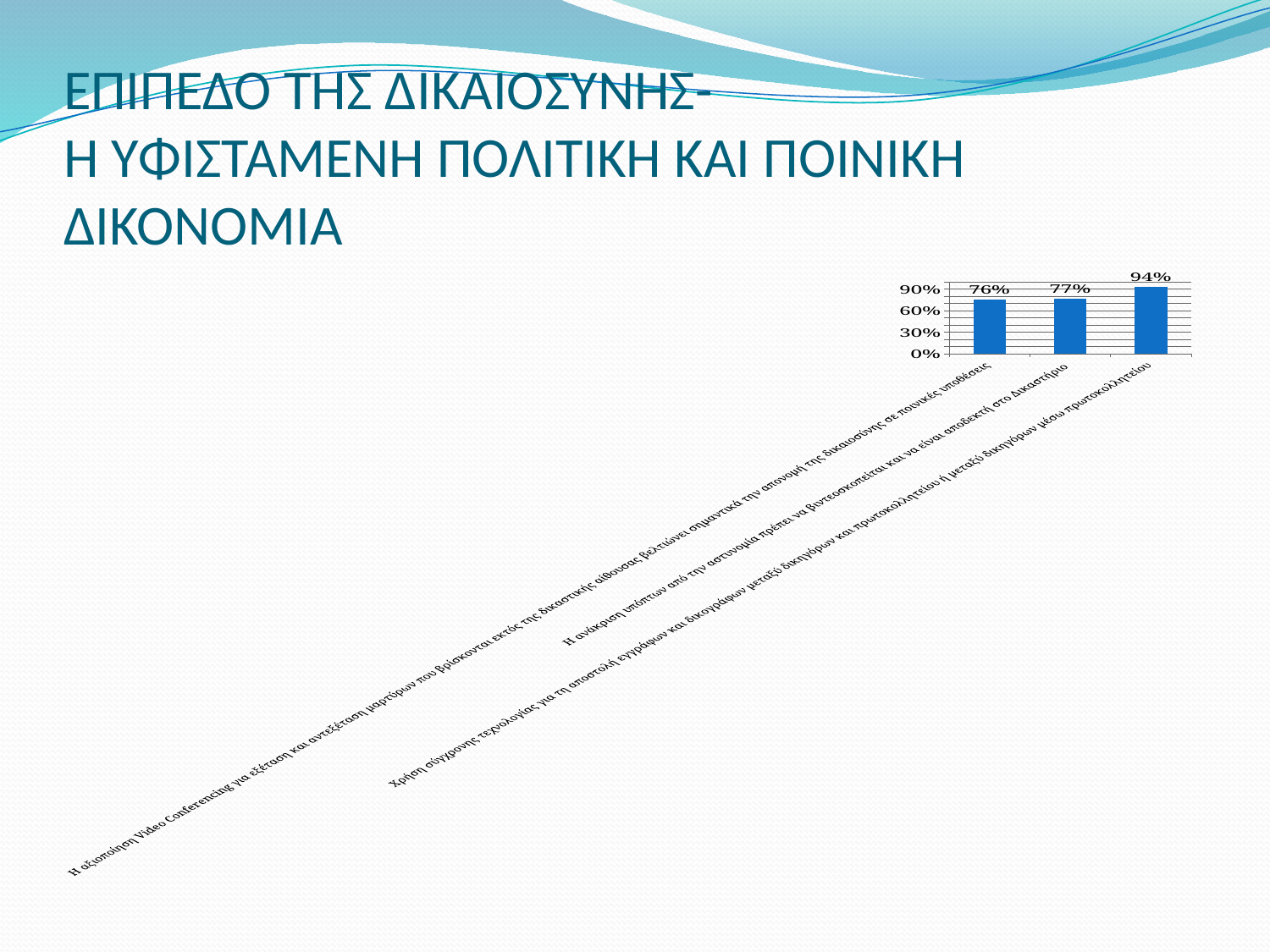
What is the difference between the highest value (94%) and the lowest value (76%)? 18% Which category has the highest value? Χρήση σύγχρονης τεχνολογίας για τη αποστολή εγγράφων και δικογράφων μεταξύ δικηγόρων και πρωτοκολλητείου ή μεταξύ δικηγόρων μέσω πρωτοκολλητείου What is the difference between the value for the police interrogation category (77%) and the Video Conferencing category (76%)? 1% What is the value for the category about using Video Conferencing for examining witnesses outside the courtroom (Η αξιοποίηση Video Conferencing...)? 76% What is the value for the category about police interrogation of suspects being video-recorded (Η ανάκριση υπόπτων από την αστυνομία...)? 77% How many bars (categories) does the chart show? 3 Do the values rise or fall from left to right across the bars? rise Is the value for the Video Conferencing category greater or less than 90%? less What is the value for the category about using modern technology to send documents between lawyers and the registry (Χρήση σύγχρονης τεχνολογίας...)? 94% Which category has the lowest value? Η αξιοποίηση Video Conferencing για εξέταση και αντεξέταση μαρτύρων που βρίσκονται εκτός της δικαστικής αίθουσας βελτιώνει σημαντικά την απονομή της δικαιοσύνης σε ποινικές υποθέσεις What type of chart is shown on the slide? bar chart Is the value for the modern technology for sending documents category greater or less than 90%? greater